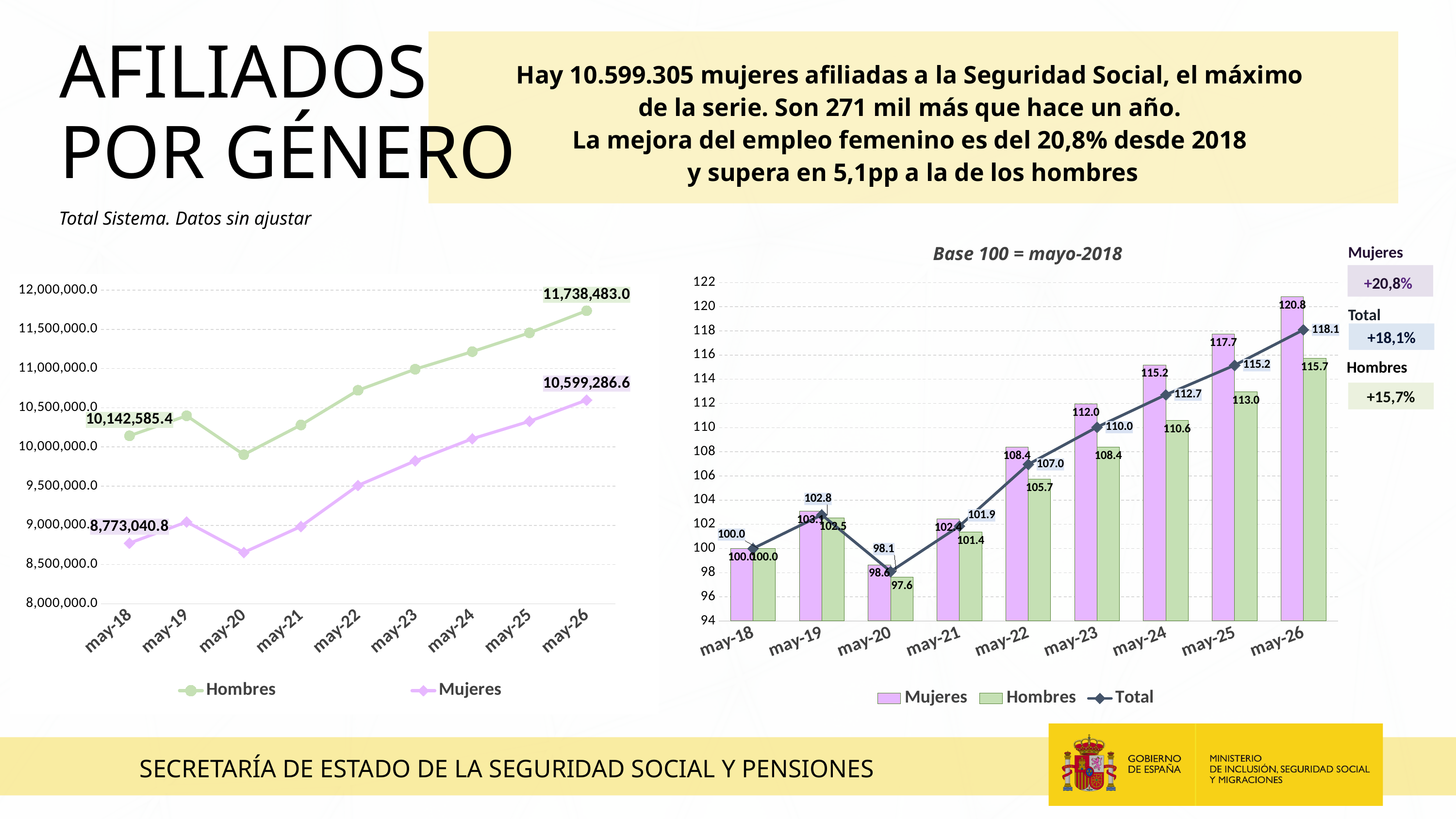
In the right chart (Base 100 = mayo-2018), what is the Mujeres value for may-26? 120.8 In the left chart, what is the value for Hombres in may-26? 11,738,483.0 In the right chart (Base 100 = mayo-2018), in which period is the Hombres value lowest? may-20 In the right chart (Base 100 = mayo-2018), what is the difference between the Mujeres and Hombres values in may-25? 4.7 In the left chart, what is the value for Mujeres in may-18? 8,773,040.8 In the right chart (Base 100 = mayo-2018), what is the Total value for may-22? 107.0 What kind of chart is the left chart? line chart In the right chart (Base 100 = mayo-2018), how many periods are shown on the x axis? 9 In the right chart (Base 100 = mayo-2018), which is larger in may-23: Mujeres or Total? Mujeres In the left chart, what is the difference between the Hombres and Mujeres values in may-26? 1,139,196.4 In the left chart, how many series does the legend list? 2 In the left chart, is the value for Mujeres in may-20 greater or less than 9,000,000.0? less